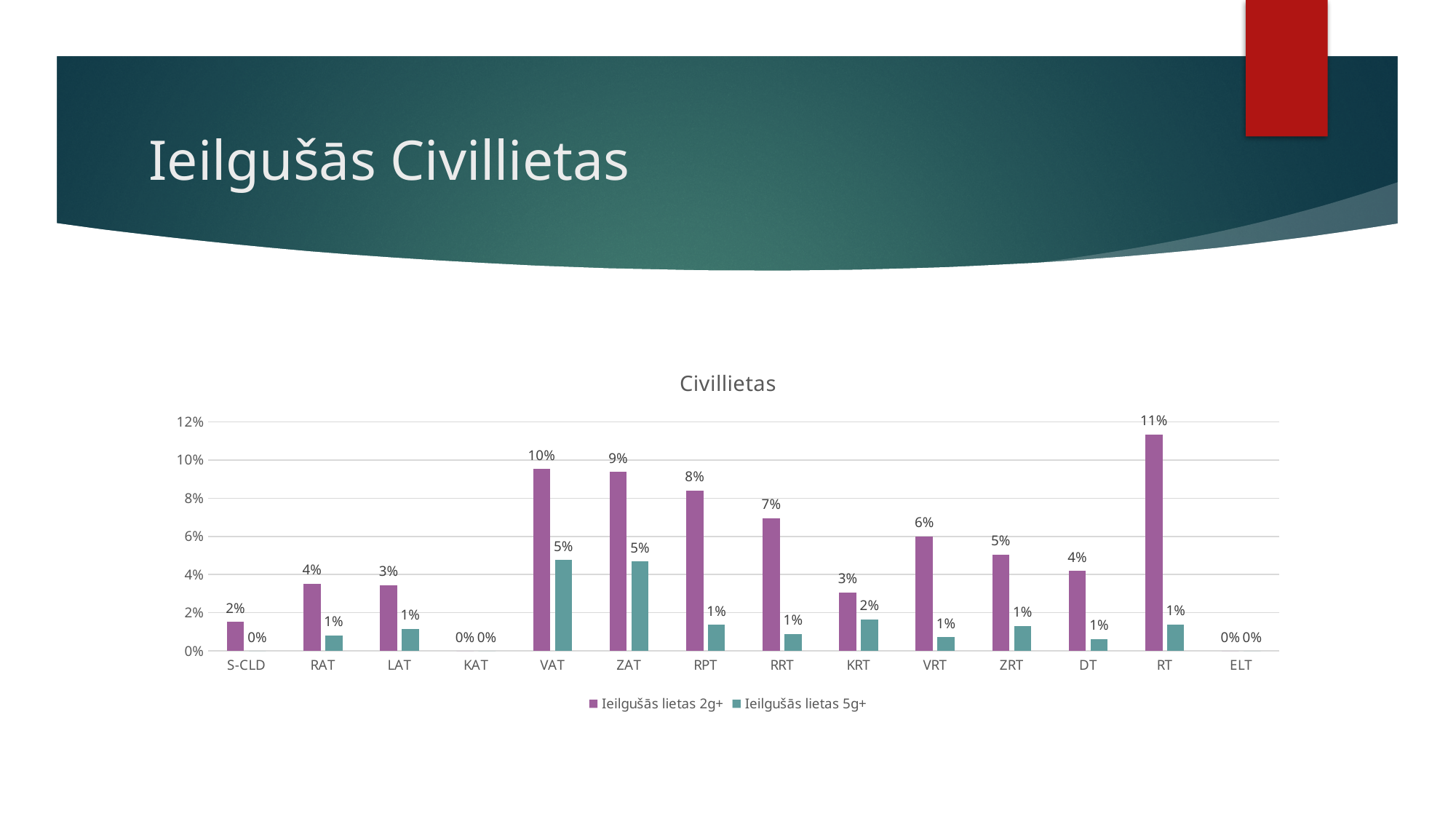
What is the title of the chart? Civillietas What is the value of Ieilgušās lietas 5g+ for KRT? 2% How many series does the legend list? 2 What is the value of Ieilgušās lietas 2g+ for VAT? 10% Which category has the highest value for Ieilgušās lietas 2g+? RT Is the value of Ieilgušās lietas 2g+ for RPT greater or less than 6%? greater What is the difference between the Ieilgušās lietas 2g+ and Ieilgušās lietas 5g+ values for RT? 10% What type of chart is shown on the slide? bar chart Which is larger for Ieilgušās lietas 2g+: VAT or ZAT? VAT How many categories are shown on the x axis? 14 What is the value of Ieilgušās lietas 2g+ for RRT? 7% Which series is shown in purple? Ieilgušās lietas 2g+